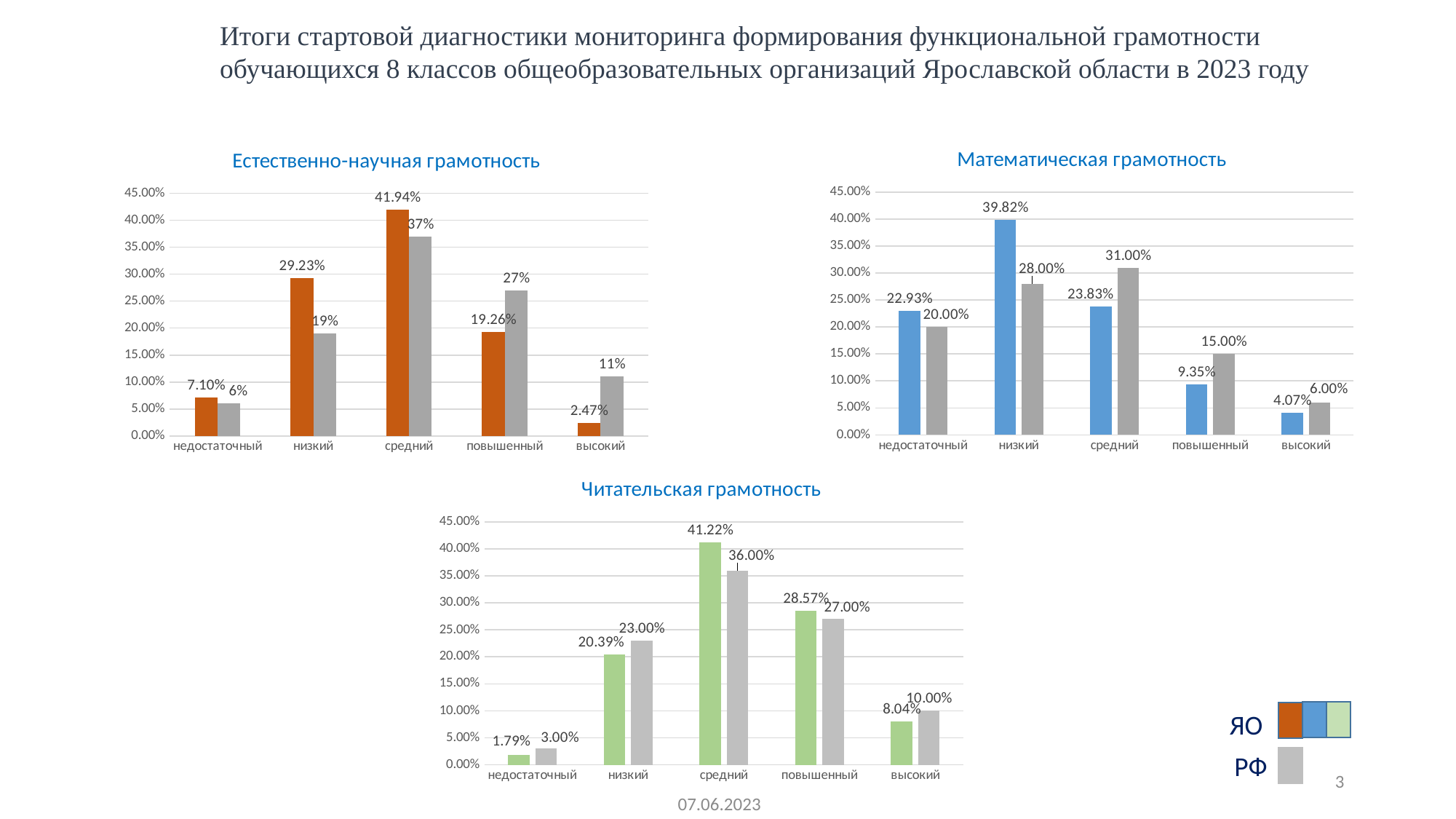
In the chart 'Читательская грамотность', what is the ЯО value for 'повышенный'? 28.57% In the chart 'Естественно-научная грамотность', what is the difference between the ЯО and РФ values for 'низкий'? 10.23% In the chart 'Математическая грамотность', which category has the highest РФ value? средний In the chart 'Естественно-научная грамотность', what is the РФ value for the 'повышенный' category? 27% What type of chart is 'Читательская грамотность'? bar chart In the chart 'Математическая грамотность', what is the ЯО value for 'низкий'? 39.82% In the chart 'Естественно-научная грамотность', which category has the lowest ЯО value? высокий In the chart 'Математическая грамотность', which is larger for 'повышенный': the ЯО value or the РФ value? РФ In the chart 'Математическая грамотность', what is the difference between the РФ and ЯО values for 'высокий'? 1.93% In the chart 'Читательская грамотность', which category has the highest ЯО value? средний In the chart 'Естественно-научная грамотность', what is the ЯО value for the 'средний' category? 41.94% How many categories are shown on the x axis of the chart 'Читательская грамотность'? 5